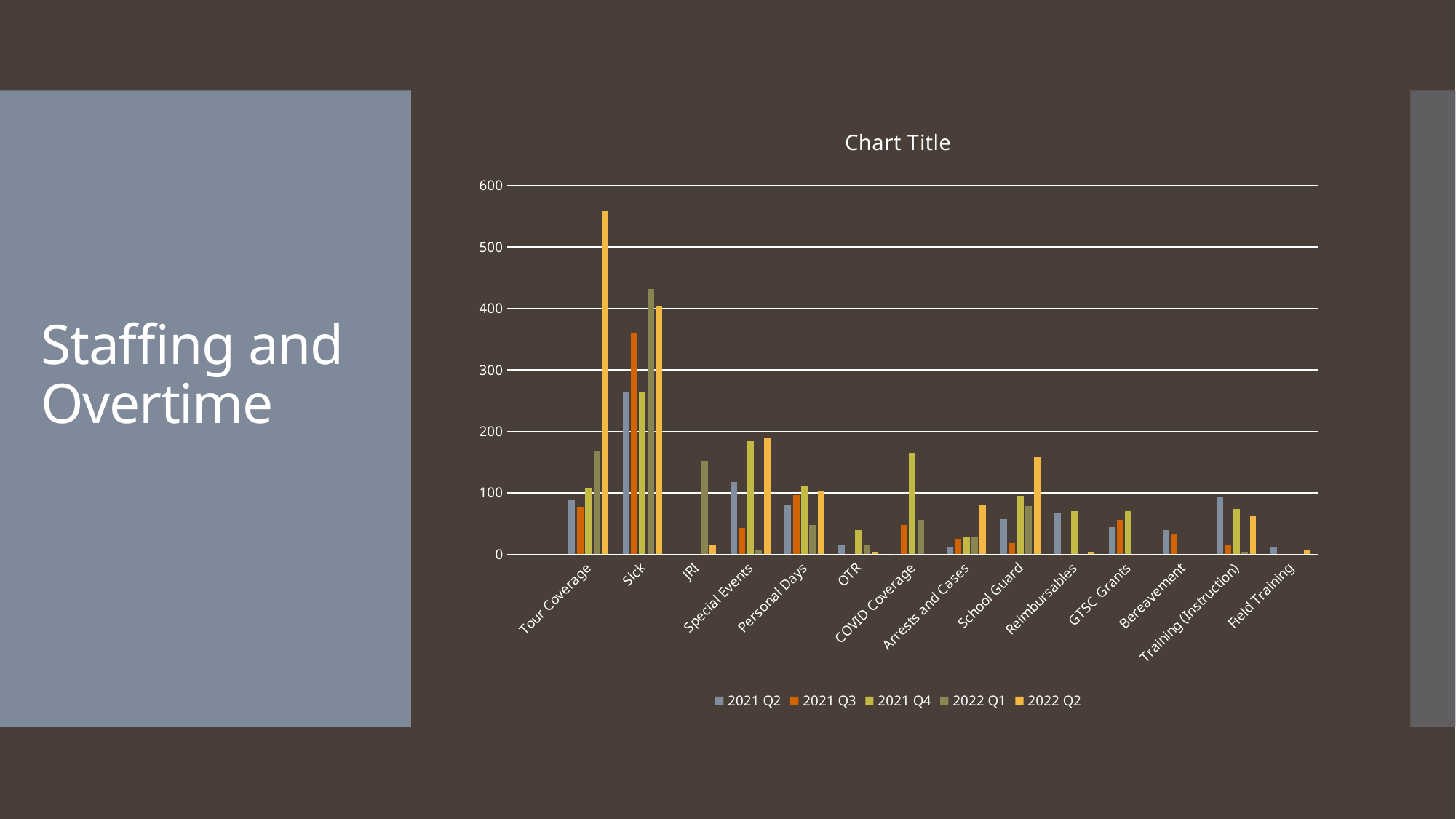
Which category contains the tallest bar in the chart? Tour Coverage Is the 2022 Q1 value for Sick greater or less than 400? greater Is the 2022 Q2 value for Tour Coverage greater or less than 500? greater What kind of chart is shown on the slide? Bar chart For the Sick category, which is larger: the 2021 Q2 value or the 2021 Q3 value? 2021 Q3 How many categories are shown along the x axis of the chart? 14 Which series is listed last in the chart legend? 2022 Q2 Is the 2022 Q2 value for School Guard greater or less than 200? less What is the title shown above the chart? Chart Title How many series does the chart legend list? 5 Within the Tour Coverage category, which series has the highest value? 2022 Q2